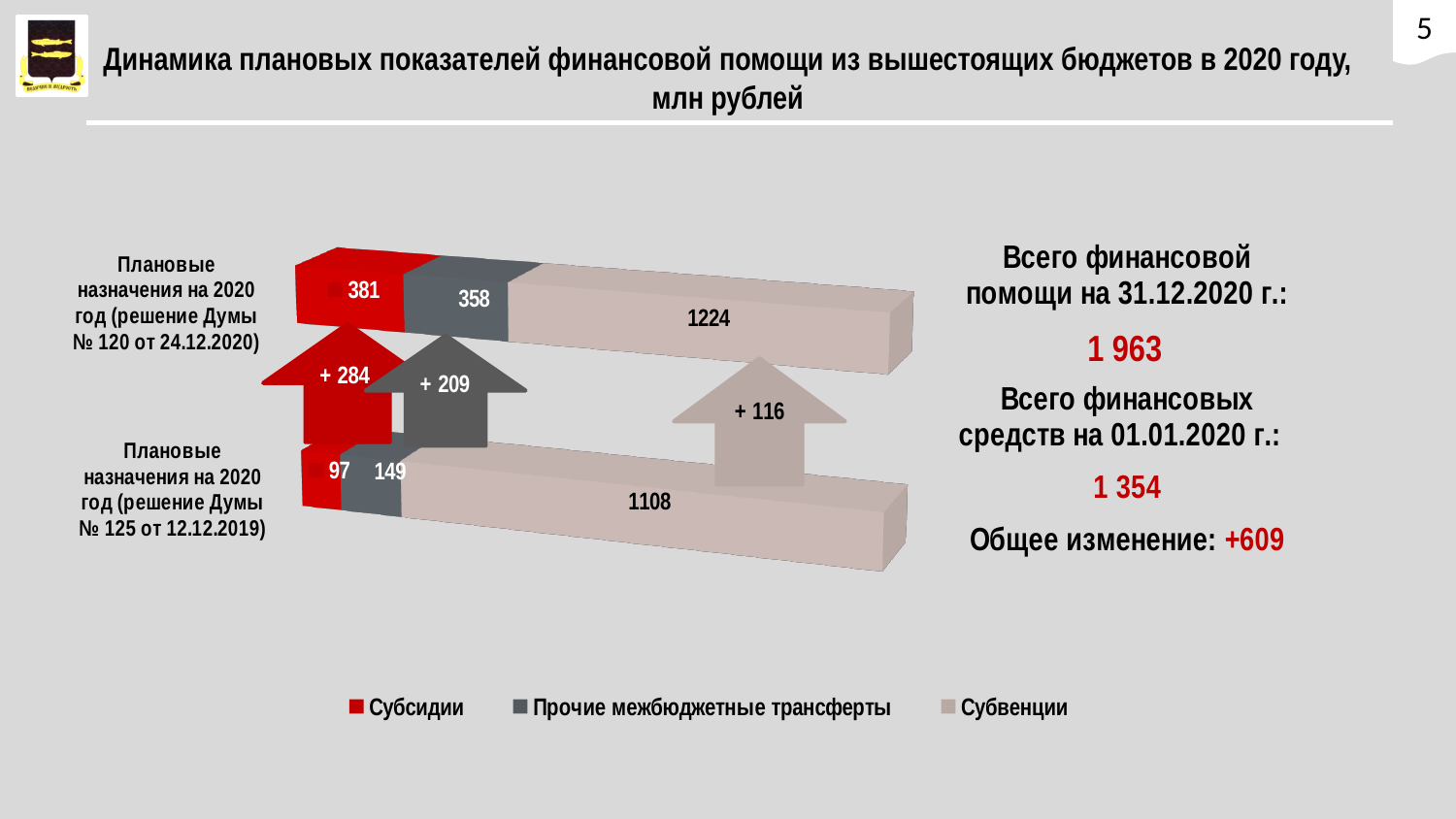
What is the value of Субсидии for Плановые назначения на 2020 год (решение Думы № 125 от 12.12.2019)? 97 What is the difference between the Субсидии values for the decision № 120 от 24.12.2020 and the decision № 125 от 12.12.2019? 284 What is the total of the stacked bar for Плановые назначения на 2020 год (решение Думы № 125 от 12.12.2019)? 1 354 Which series has the largest value in the bar for the decision № 125 от 12.12.2019? Субвенции What is the value of Прочие межбюджетные трансферты for Плановые назначения на 2020 год (решение Думы № 125 от 12.12.2019)? 149 How many series does the legend list? 3 What is the difference between the Субвенции values for the decision № 120 от 24.12.2020 and the decision № 125 от 12.12.2019? 116 What type of chart is shown on the slide? Stacked bar chart How many categories (bars) are plotted in the chart? 2 What is the value of Субвенции for Плановые назначения на 2020 год (решение Думы № 120 от 24.12.2020)? 1224 What is the value of Прочие межбюджетные трансферты for Плановые назначения на 2020 год (решение Думы № 120 от 24.12.2020)? 358 What is the total of the stacked bar for Плановые назначения на 2020 год (решение Думы № 120 от 24.12.2020)? 1 963